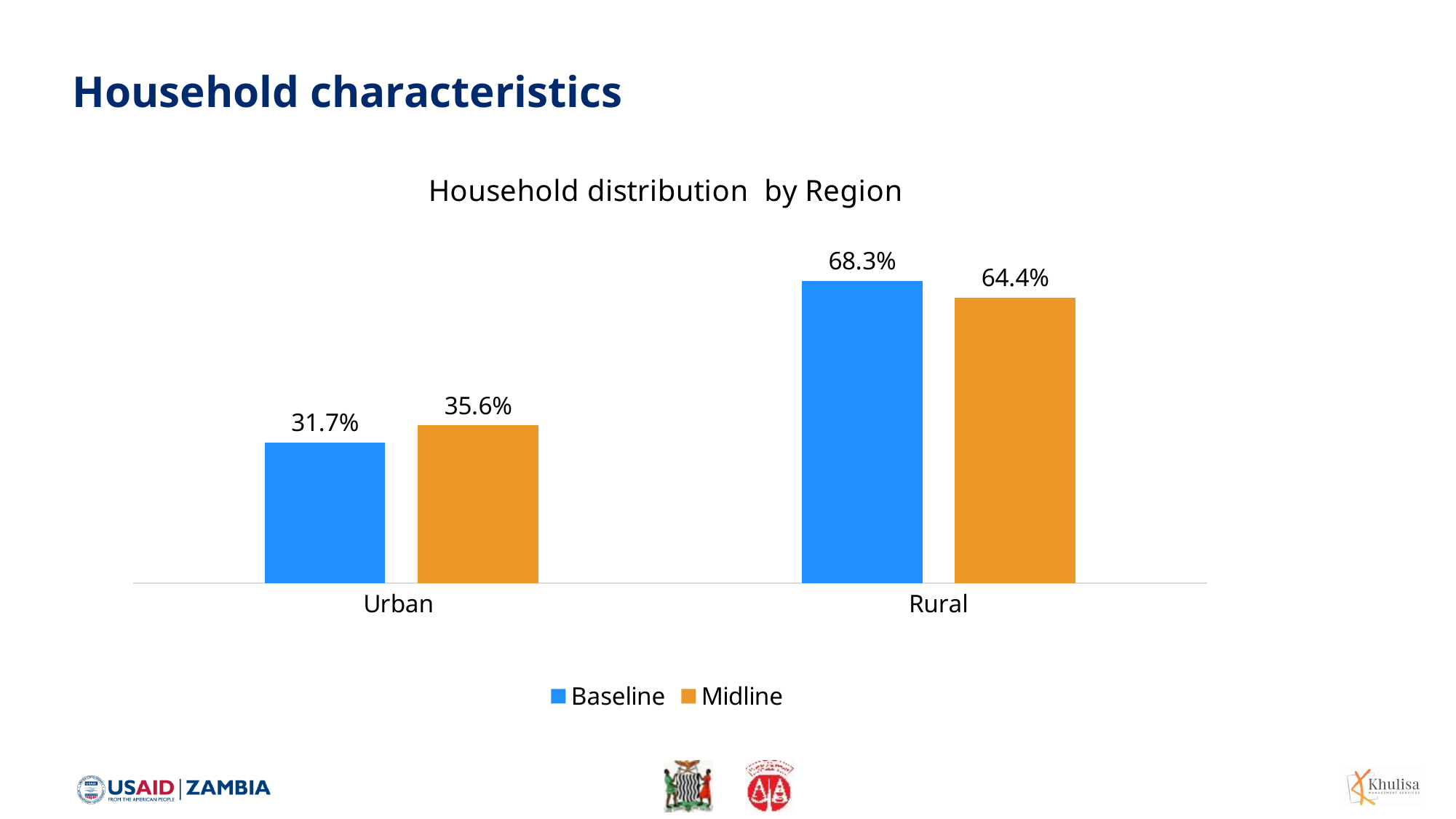
What is the Midline value for Rural? 64.4% What kind of chart is shown on the slide? Bar chart What is the difference between the Midline and Baseline values for Urban? 3.9% Which is larger for Urban, the Baseline or the Midline value? Midline Which region has the highest Baseline value? Rural What is the difference between the Baseline and Midline values for Rural? 3.9% How many regions are shown on the x axis? 2 Which region has the lowest Midline value? Urban What is the Midline value for Urban? 35.6% How many series does the legend list? 2 What is the Baseline value for Urban? 31.7% What is the Baseline value for Rural? 68.3%